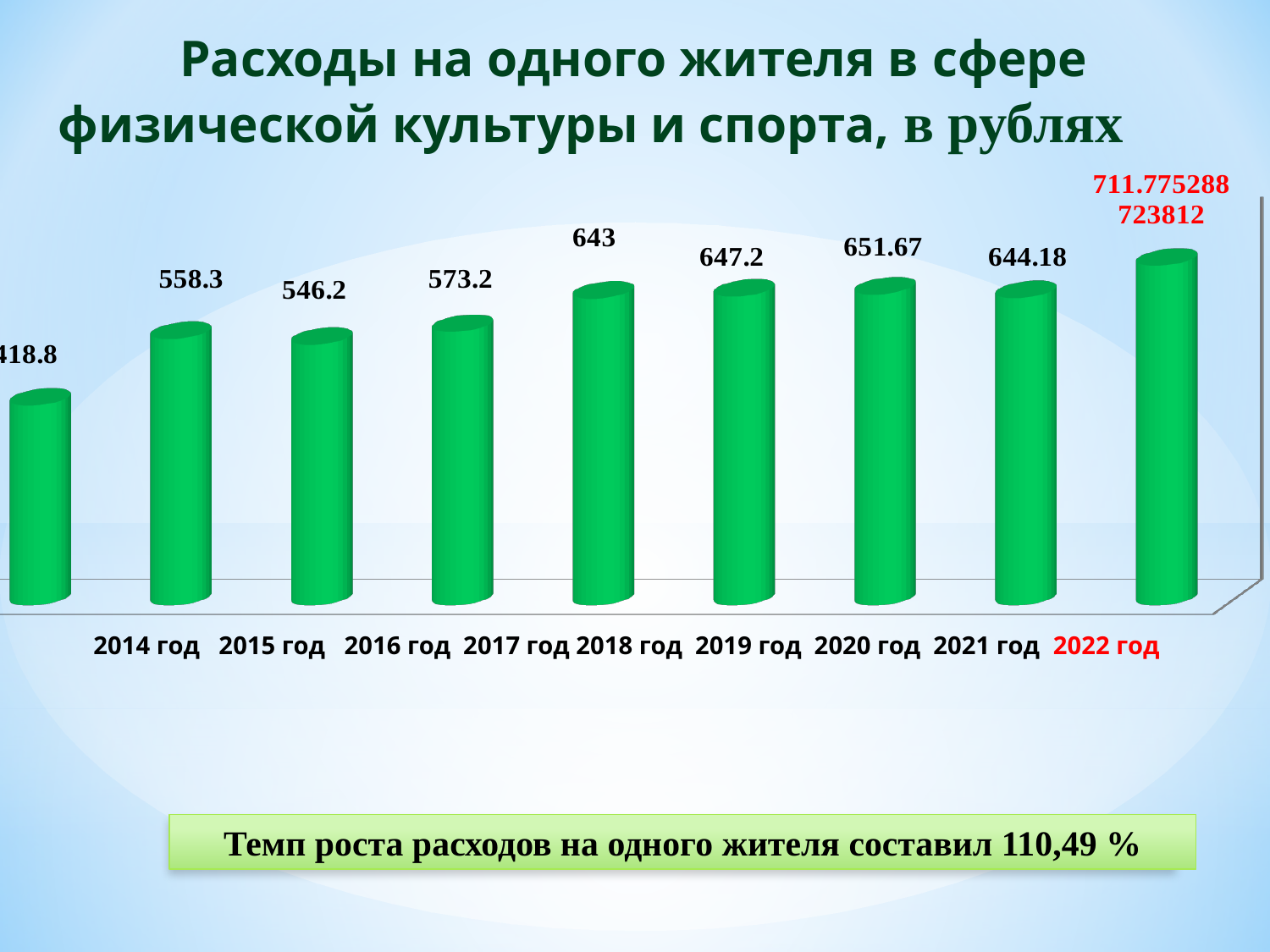
What is the difference between the values for 2017 год and 2016 год? 27 What is the value for 2018 год? 643 What is the value for 2020 год? 651.67 What kind of chart is shown on the slide? bar chart Which year has the lowest value? 2014 год What is the difference between the values for 2019 год and 2018 год? 4.2 Which is larger, the value for 2015 год or 2016 год? 2015 год Which year has the highest value? 2022 год What is the value for 2016 год? 546.2 How many years are shown on the chart? 9 What is the difference between the values for 2020 год and 2021 год? 7.49 What is the value for 2021 год? 644.18